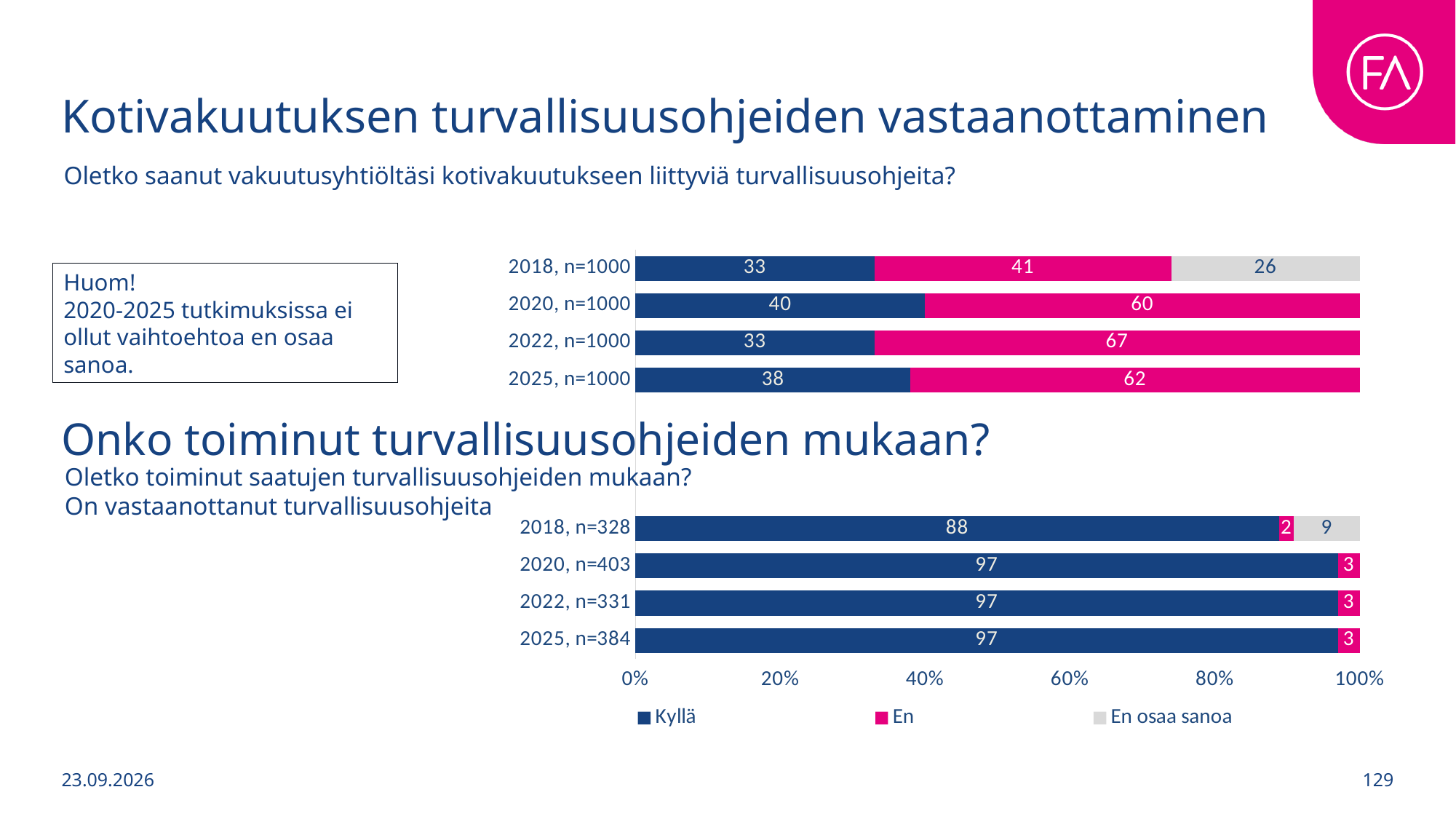
In the top chart (Kotivakuutuksen turvallisuusohjeiden vastaanottaminen), how many year categories are shown? 4 In the top chart (Kotivakuutuksen turvallisuusohjeiden vastaanottaminen), what is the Kyllä value for 2018, n=1000? 33 In the bottom chart (Onko toiminut turvallisuusohjeiden mukaan?), what is the En value for 2025, n=384? 3 How many series does the legend list? 3 In the top chart (Kotivakuutuksen turvallisuusohjeiden vastaanottaminen), what is the difference between the En values for 2022, n=1000 and 2018, n=1000? 26 In the bottom chart (Onko toiminut turvallisuusohjeiden mukaan?), what is the Kyllä value for 2018, n=328? 88 In the bottom chart (Onko toiminut turvallisuusohjeiden mukaan?), which year has the lowest Kyllä value? 2018, n=328 In the bottom chart (Onko toiminut turvallisuusohjeiden mukaan?), is the Kyllä value for 2020, n=403 greater or less than 80%? greater In the top chart (Kotivakuutuksen turvallisuusohjeiden vastaanottaminen), what is the En osaa sanoa value for 2018, n=1000? 26 In the top chart (Kotivakuutuksen turvallisuusohjeiden vastaanottaminen), which year has the highest Kyllä value? 2020, n=1000 What kind of chart is the bottom chart (Onko toiminut turvallisuusohjeiden mukaan?)? Stacked bar chart In the top chart (Kotivakuutuksen turvallisuusohjeiden vastaanottaminen), what is the En value for 2022, n=1000? 67